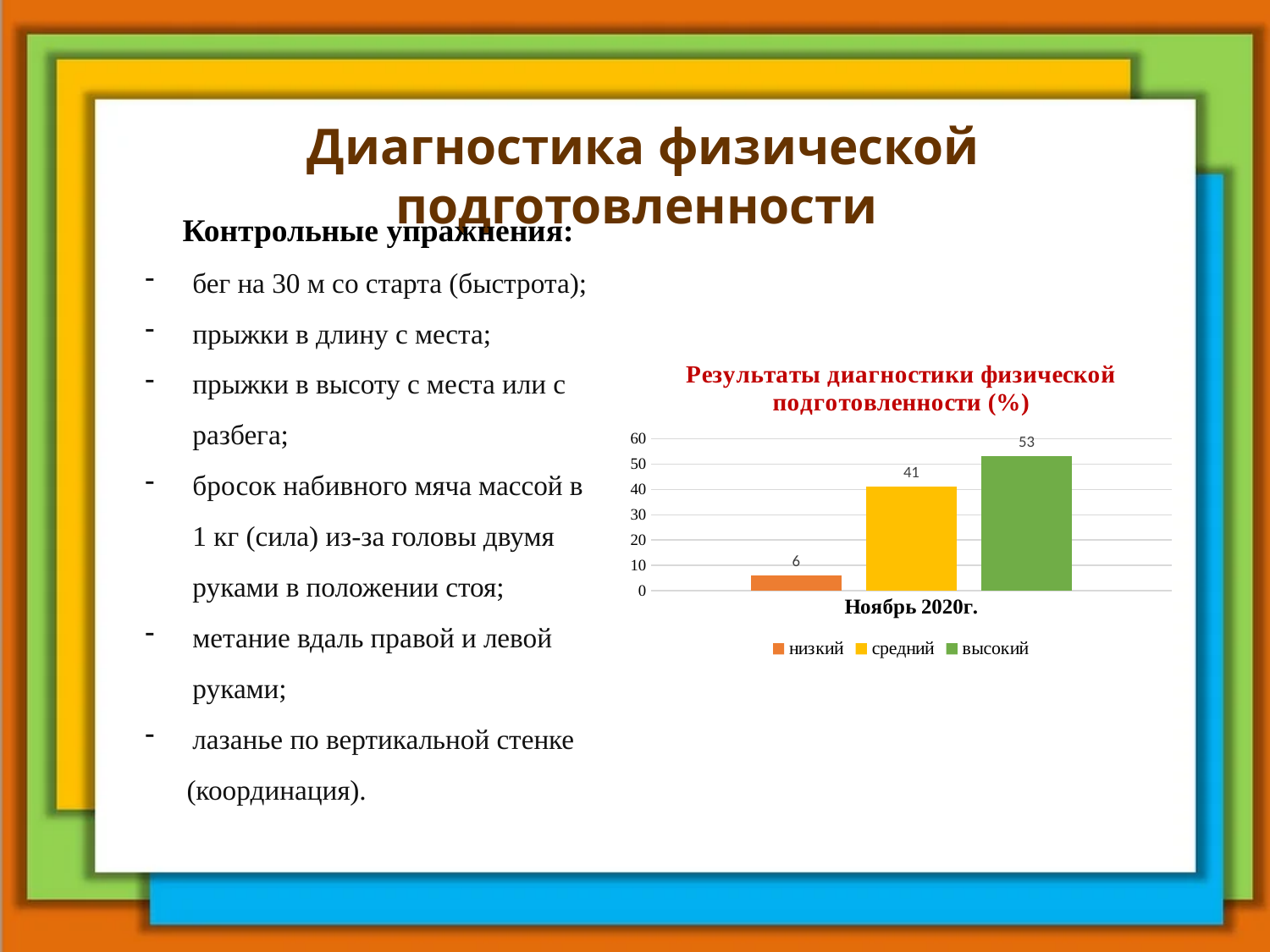
What is the value for the 'высокий' series in the chart? 53 How many series does the legend list? 3 What is the category label shown on the x axis of the chart? Ноябрь 2020г. Which is larger, the value for 'средний' or the value for 'низкий'? средний What is the value for the 'низкий' series in the chart? 6 Is the value for 'высокий' greater or less than 50? greater What is the difference between the 'высокий' and 'средний' values? 12 Which series has the lowest value in the chart? низкий What is the value for the 'средний' series in the chart? 41 What is the difference between the 'средний' and 'низкий' values? 35 Which series has the highest value in the chart? высокий What kind of chart is shown on the slide? bar chart